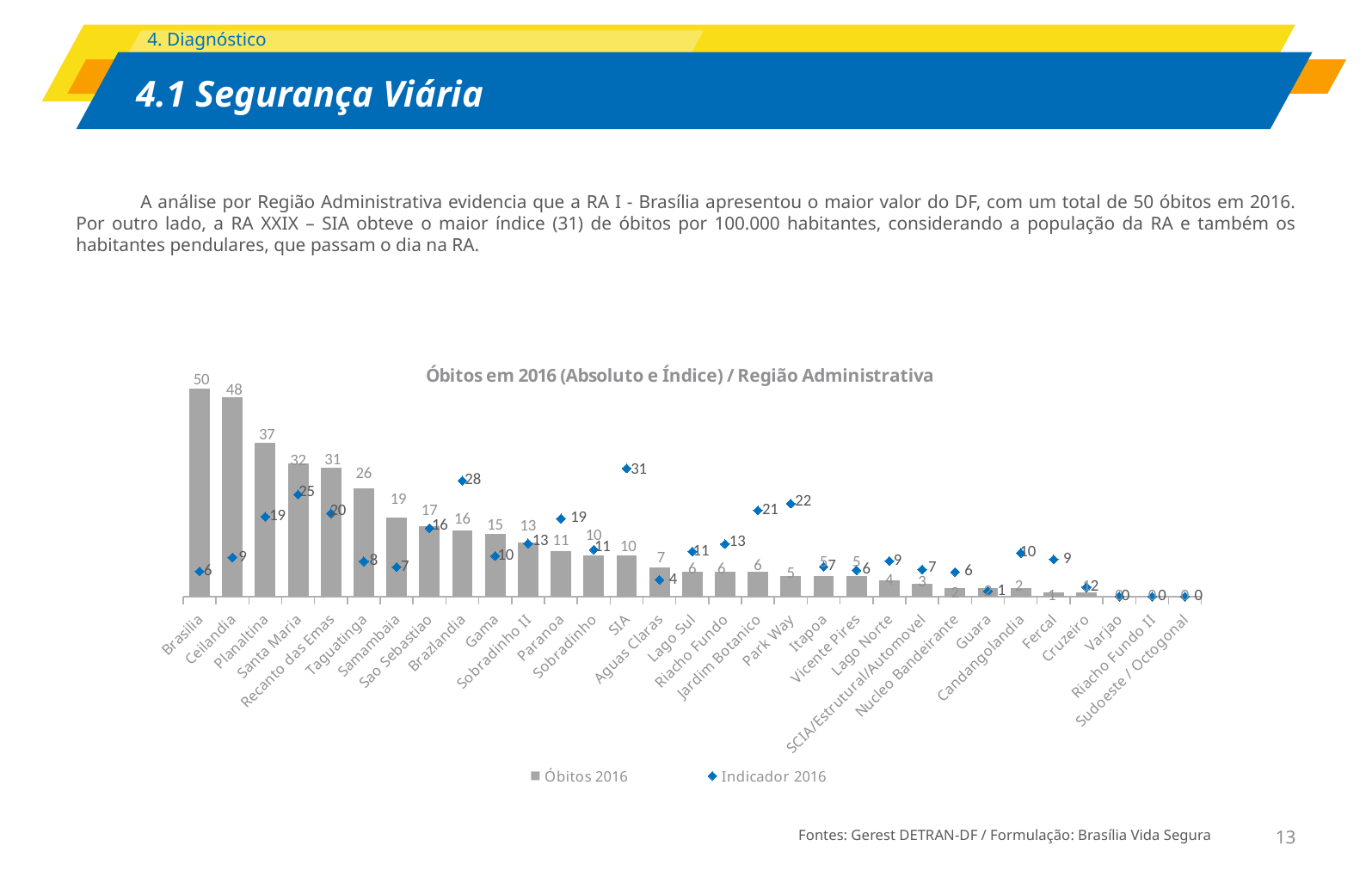
What is the difference between the Óbitos 2016 values for Brasilia and Ceilandia? 2 What is the value of Óbitos 2016 for Taguatinga? 26 What is the title of the chart? Óbitos em 2016 (Absoluto e Índice) / Região Administrativa Which Região Administrativa has the highest Óbitos 2016 value? Brasilia What is the value of Indicador 2016 for Brazlandia? 28 What is the value of Indicador 2016 for SIA? 31 What is the value of Óbitos 2016 for Brasilia? 50 How many Regiões Administrativas are shown on the x axis? 31 How many series does the legend list? 2 Which Região Administrativa has the highest Indicador 2016 value? SIA Which is larger, the Indicador 2016 value for Santa Maria or for Planaltina? Santa Maria Do the Óbitos 2016 bars rise or fall from left to right along the x axis? fall